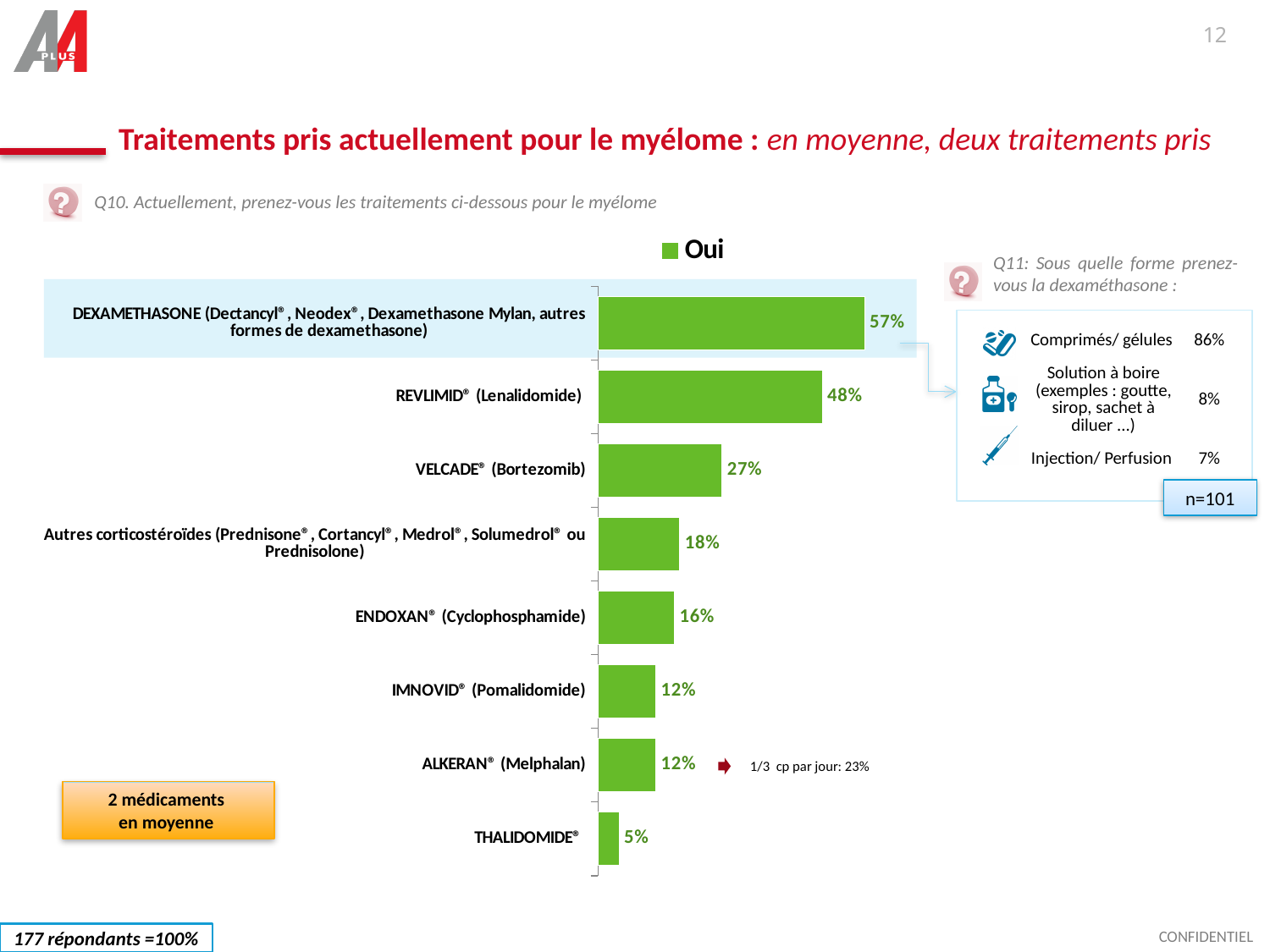
What is the value shown for VELCADE (Bortezomib)? 27% How many treatments (categories) are shown in the bar chart? 8 What type of chart is used on this slide? Bar chart What is the name of the series shown in the chart legend? Oui What percentage of respondents currently take REVLIMID (Lenalidomide)? 48% Which treatment has the lowest percentage in the chart? THALIDOMIDE Which treatment has the highest percentage in the chart? DEXAMETHASONE How many series does the chart legend list? 1 What is the difference in percentage points between DEXAMETHASONE and REVLIMID? 9 What is the difference in percentage points between VELCADE and THALIDOMIDE? 22 What percentage is shown for ENDOXAN (Cyclophosphamide)? 16% Which is larger, the value for Autres corticostéroïdes or the value for ENDOXAN? Autres corticostéroïdes